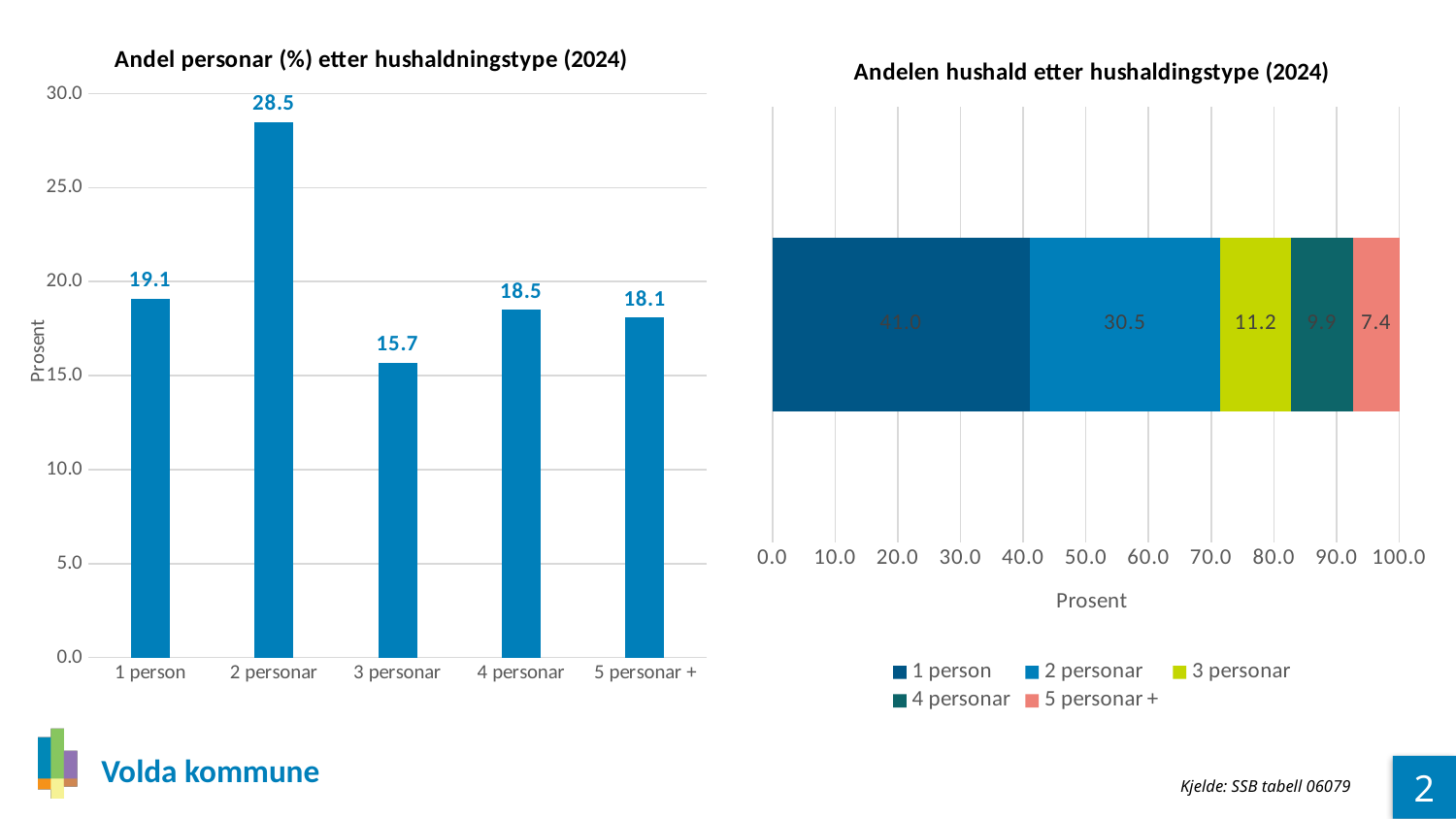
In the chart 'Andel personar (%) etter hushaldningstype (2024)', which household type has the highest value? 2 personar In the chart 'Andel personar (%) etter hushaldningstype (2024)', what is the value for 2 personar? 28.5 What kind of chart is 'Andel personar (%) etter hushaldningstype (2024)'? Bar chart In the chart 'Andelen hushald etter hushaldingstype (2024)', what is the axis title of the horizontal axis? Prosent In the chart 'Andel personar (%) etter hushaldningstype (2024)', which is larger: the value for 4 personar or 5 personar +? 4 personar In the chart 'Andel personar (%) etter hushaldningstype (2024)', what is the value for 3 personar? 15.7 In the chart 'Andelen hushald etter hushaldingstype (2024)', what is the value for 2 personar? 30.5 In the chart 'Andel personar (%) etter hushaldningstype (2024)', which household type has the lowest value? 3 personar How many household types are shown in the chart 'Andel personar (%) etter hushaldningstype (2024)'? 5 In the chart 'Andel personar (%) etter hushaldningstype (2024)', what is the difference between the values for 2 personar and 1 person? 9.4 How many series does the legend of the chart 'Andelen hushald etter hushaldingstype (2024)' list? 5 In the chart 'Andelen hushald etter hushaldingstype (2024)', what is the value for 5 personar +? 7.4